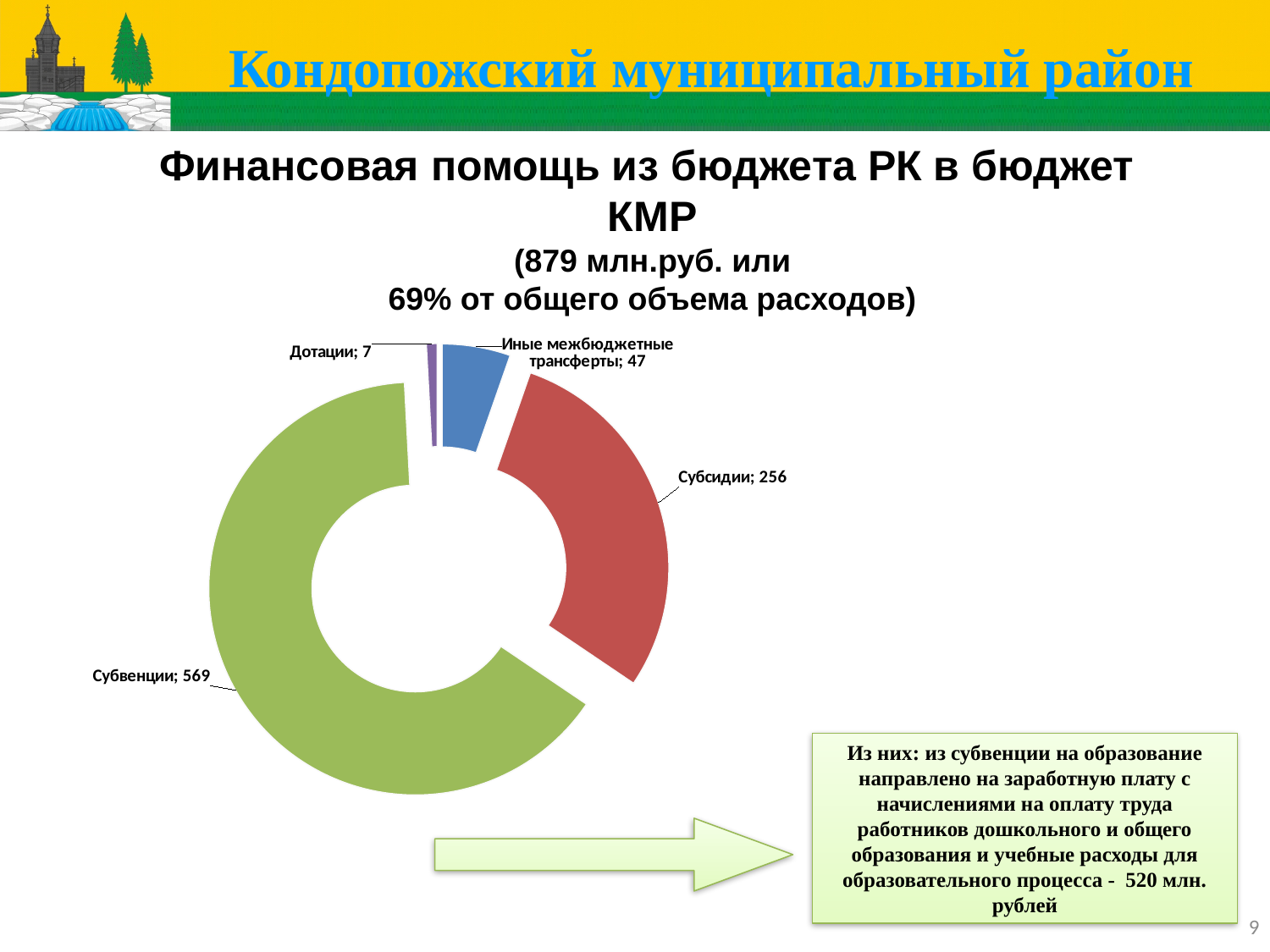
What is the value for Субвенции? 569 What type of chart is shown on the slide? doughnut chart What is the value for Иные межбюджетные трансферты? 47 Which is larger, the value for Субсидии or the value for Иные межбюджетные трансферты? Субсидии How many categories are shown in the chart? 4 What is the difference between the values for Иные межбюджетные трансферты and Дотации? 40 What is the value for Субсидии? 256 What is the value for Дотации? 7 Which category has the largest value? Субвенции Which category has the smallest value? Дотации What is the total of all four categories in the chart? 879 What is the difference between the values for Субвенции and Субсидии? 313